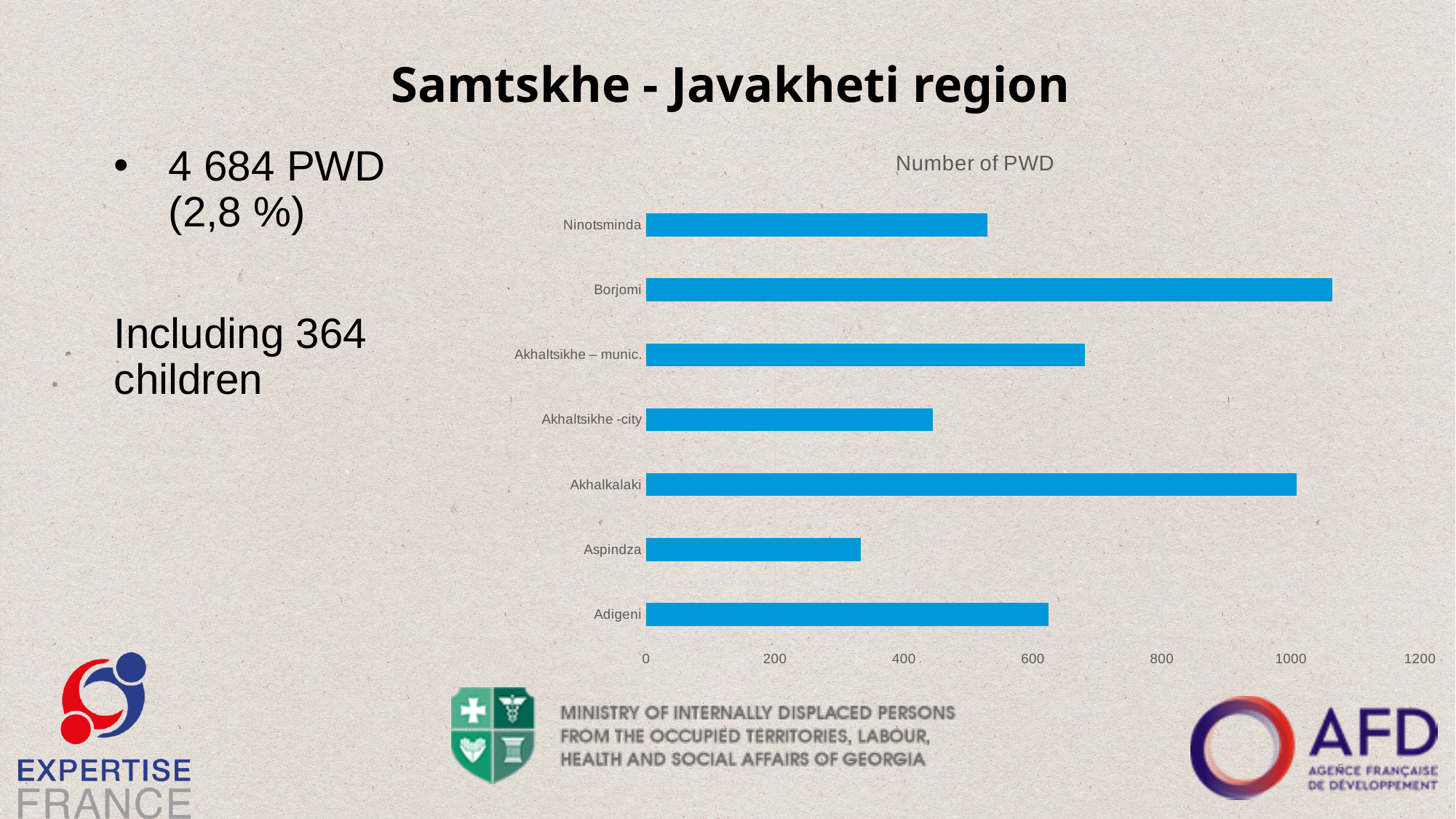
Is the value for Borjomi greater or less than 1000? greater Is the value for Akhalkalaki greater or less than 800? greater Is the value for Ninotsminda greater or less than 400? greater Which has more PWD, Akhaltsikhe – munic. or Akhaltsikhe -city? Akhaltsikhe – munic. What is the title of the chart? Number of PWD Which municipality has the lowest number of PWD? Aspindza How many municipalities are plotted in the chart? 7 What kind of chart is shown on the slide? bar chart Which municipality has the highest number of PWD? Borjomi Which has more PWD, Adigeni or Ninotsminda? Adigeni